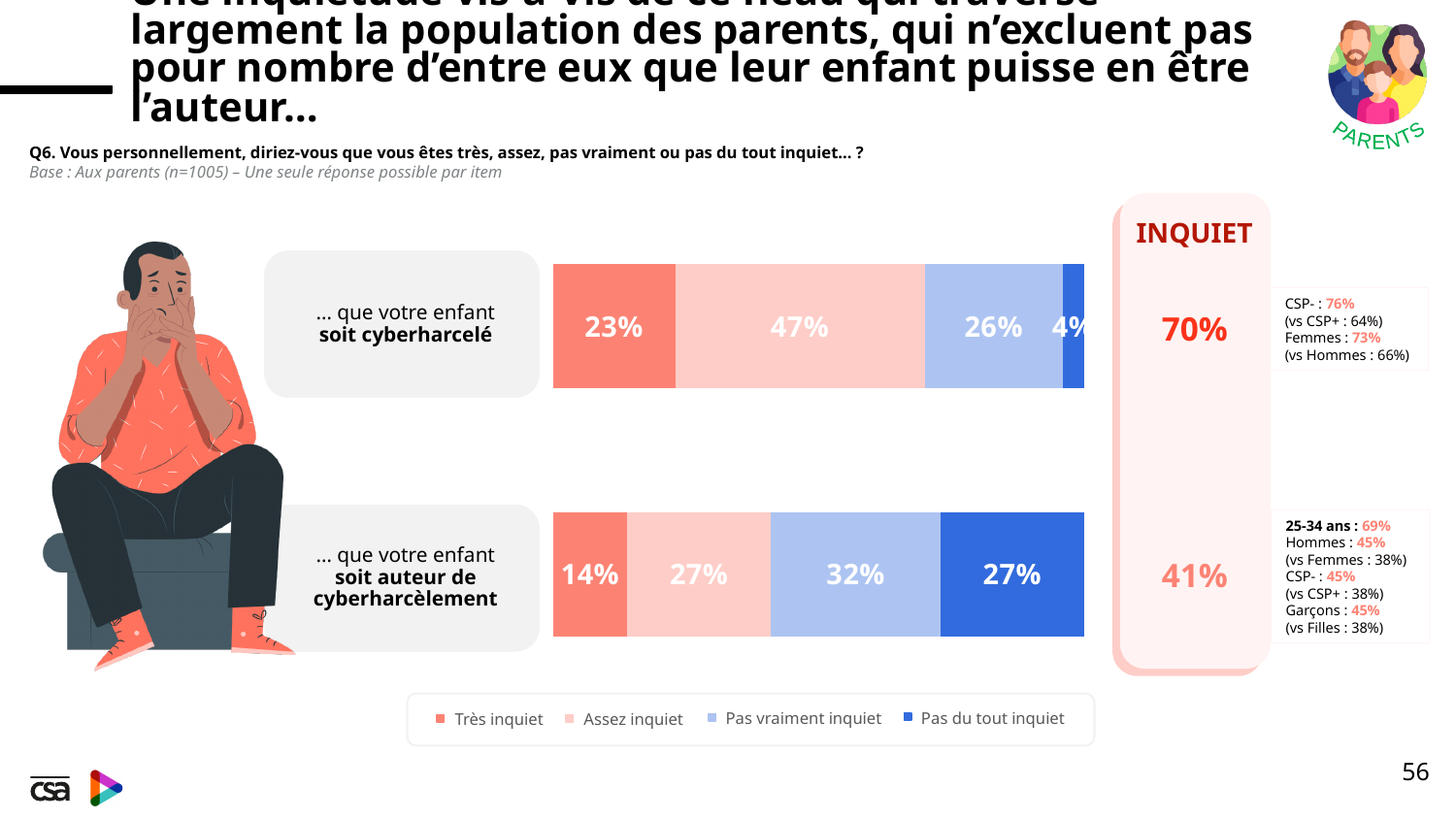
What percentage of parents are 'Pas du tout inquiet' that their child might be the author of cyberbullying (soit auteur de cyberharcèlement)? 27% How many items (categories) are plotted in the chart? 2 How many series does the legend list? 4 What is the 'INQUIET' total shown for the item 'que votre enfant soit auteur de cyberharcèlement'? 41% What percentage of parents are 'Assez inquiet' that their child might be cyberbullied (soit cyberharcelé)? 47% What is the 'INQUIET' total shown for the item 'que votre enfant soit cyberharcelé'? 70% What kind of chart is shown on the slide? Stacked bar chart What percentage of parents are 'Très inquiet' that their child might be cyberbullied (soit cyberharcelé)? 23% What is the combined share of 'Très inquiet' and 'Assez inquiet' for the item 'soit auteur de cyberharcèlement'? 41% What is the difference between the 'Très inquiet' shares for 'soit cyberharcelé' and 'soit auteur de cyberharcèlement'? 9 points Which item has the larger 'Pas du tout inquiet' share: 'soit cyberharcelé' or 'soit auteur de cyberharcèlement'? soit auteur de cyberharcèlement What percentage of parents are 'Pas vraiment inquiet' that their child might be the author of cyberbullying? 32%